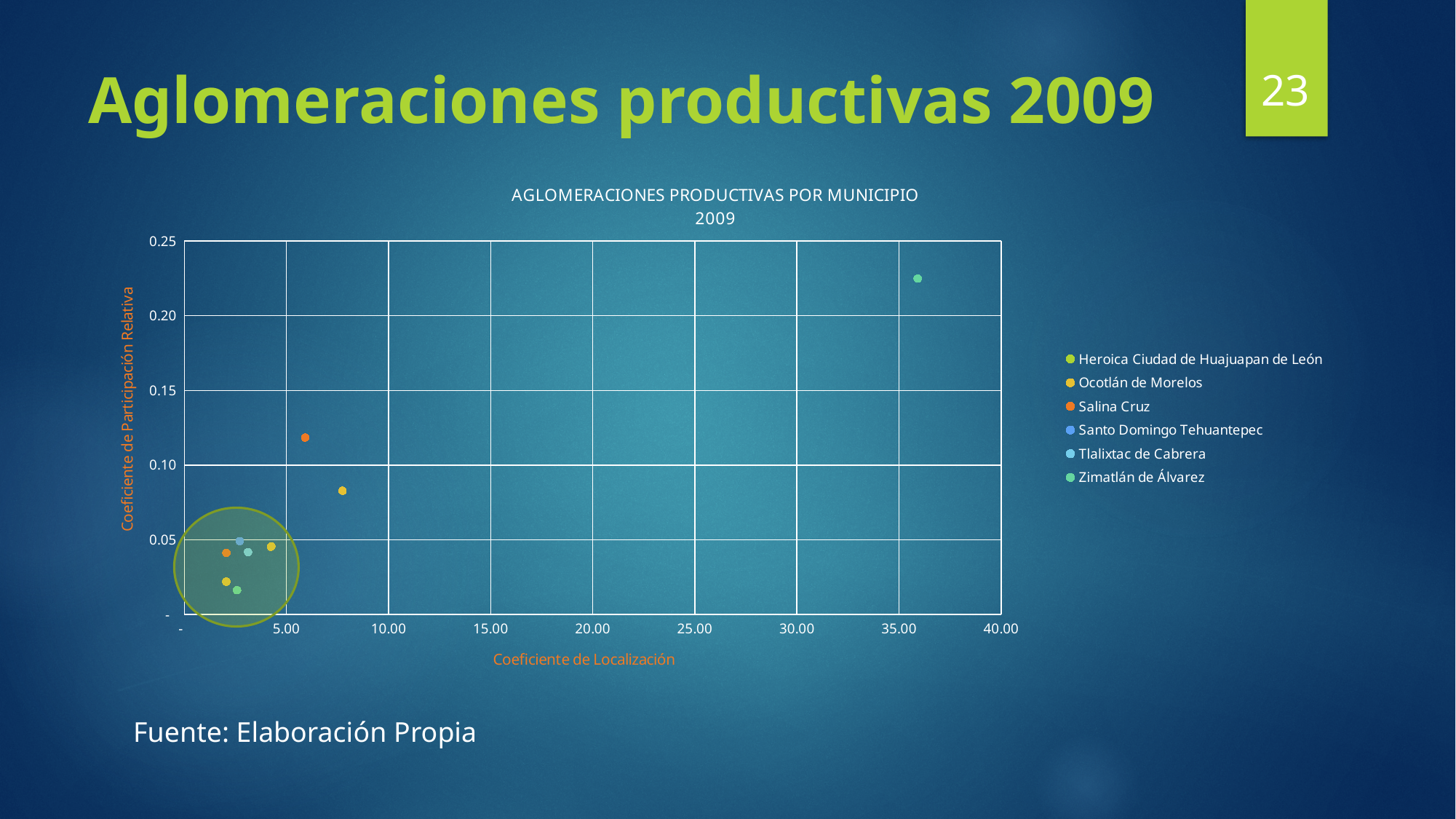
Is the Coeficiente de Participación Relativa of the highest point greater or less than 0.20? greater What is the label of the horizontal axis? Coeficiente de Localización Which series has the highest point on the chart? Zimatlán de Álvarez Is the Coeficiente de Localización of the rightmost point greater or less than 30.00? greater How many series does the legend list? 6 Which has a higher Coeficiente de Participación Relativa: the highest Salina Cruz point or the highest Ocotlán de Morelos point? Salina Cruz Is the Coeficiente de Localización of the rightmost Ocotlán de Morelos point greater or less than 5.00? greater What is the title of the chart? AGLOMERACIONES PRODUCTIVAS POR MUNICIPIO 2009 What kind of chart is shown on the slide? scatter chart Which series has the point farthest to the right on the chart? Zimatlán de Álvarez